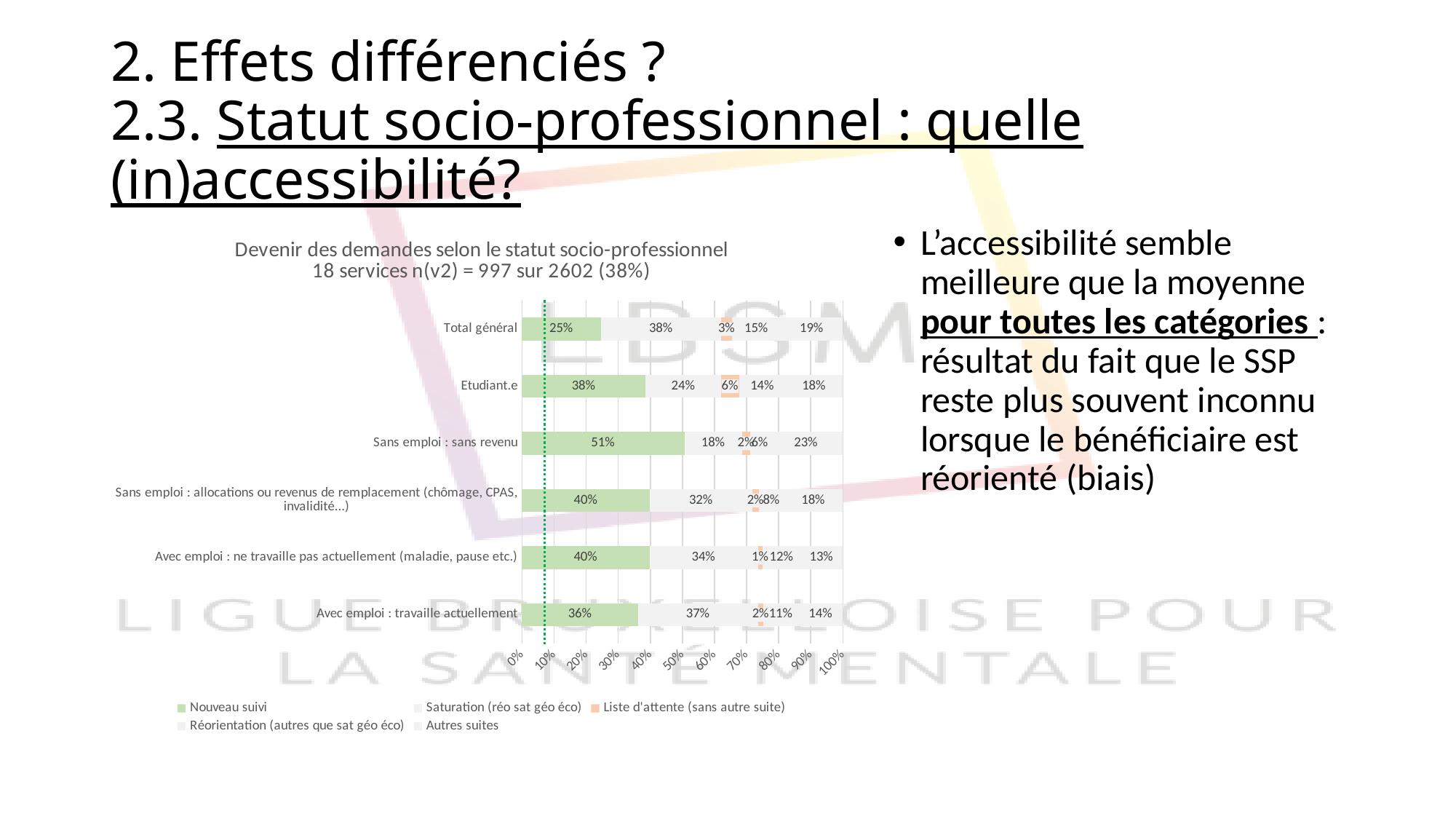
How many series does the legend list? 5 What is the Réorientation (autres que sat géo éco) value for Avec emploi : ne travaille pas actuellement (maladie, pause etc.)? 12% What is the difference in Nouveau suivi between Sans emploi : sans revenu and Total général? 26 percentage points Which category has the lowest Nouveau suivi value? Total général What kind of chart is shown on the slide? Stacked bar chart What is the title of the chart? Devenir des demandes selon le statut socio-professionnel 18 services n(v2) = 997 sur 2602 (38%) Which is larger for Avec emploi : travaille actuellement, Nouveau suivi or Saturation (réo sat géo éco)? Saturation (réo sat géo éco) What is the Nouveau suivi value for Etudiant.e? 38% How many categories are shown on the chart? 6 What is the Autres suites value for Sans emploi : sans revenu? 23% Which category has the highest Nouveau suivi value? Sans emploi : sans revenu What is the Saturation (réo sat géo éco) value for Total général? 38%